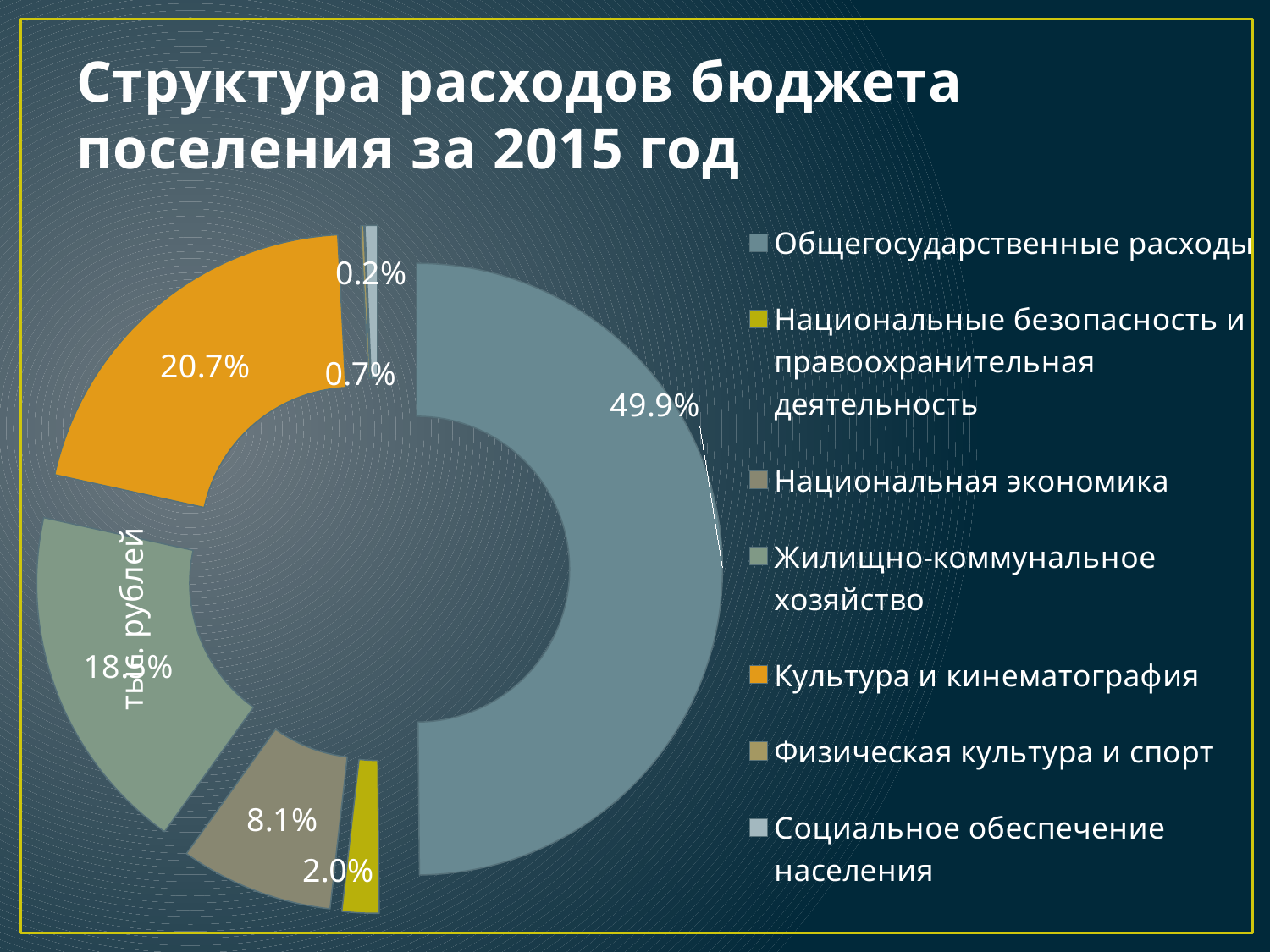
What share of the budget expenditure goes to Национальные безопасность и правоохранительная деятельность? 2.0% What share of the budget expenditure goes to Социальное обеспечение населения? 0.7% Which has a larger share: Культура и кинематография or Национальная экономика? Культура и кинематография By how many percentage points does the share of Культура и кинематография exceed that of Национальная экономика? 12.6 How many expenditure categories does the chart show? 7 Which expenditure category has the smallest share? Физическая культура и спорт Which expenditure category has the largest share? Общегосударственные расходы What share of the budget expenditure goes to Физическая культура и спорт? 0.2% What type of chart is shown on the slide? Pie (doughnut) chart What share of the budget expenditure goes to Культура и кинематография? 20.7% What share of the budget expenditure goes to Национальная экономика? 8.1% What share of the budget expenditure goes to Общегосударственные расходы? 49.9%